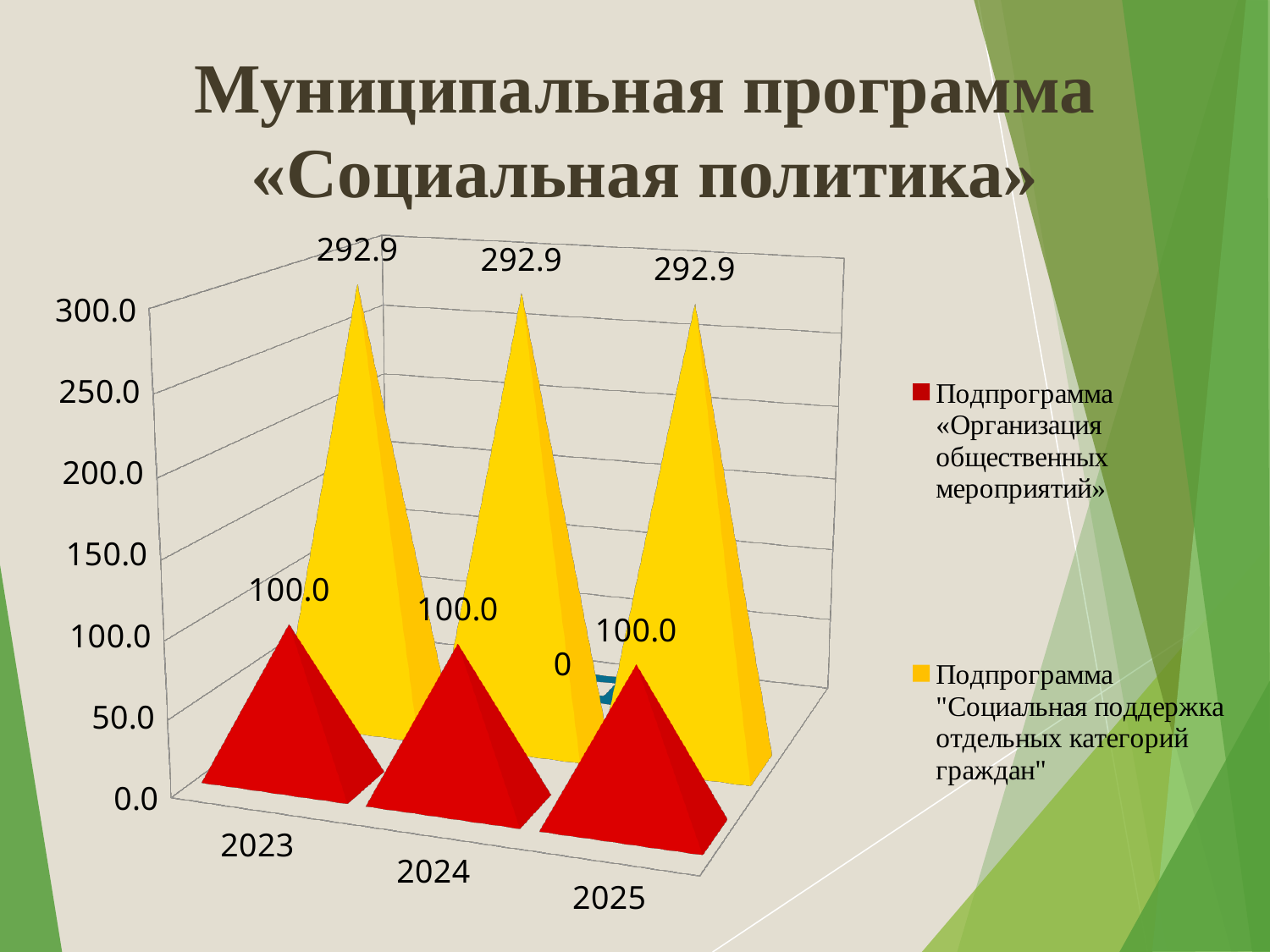
What kind of chart is shown on the slide? Bar chart What is the value for the red series «Организация общественных мероприятий» in 2023? 100.0 How many series does the legend list? 2 What is the value for the yellow series "Социальная поддержка отдельных категорий граждан" in 2024? 292.9 What is the value for the yellow series "Социальная поддержка отдельных категорий граждан" in 2025? 292.9 What is the difference between the yellow and red series values in 2024? 192.9 What colour represents the series "Социальная поддержка отдельных категорий граждан"? Yellow Is the value for the red series in 2024 greater or less than 150.0? less Which series has the larger value in 2023, «Организация общественных мероприятий» or "Социальная поддержка отдельных категорий граждан"? "Социальная поддержка отдельных категорий граждан" What is the value for the red series «Организация общественных мероприятий» in 2025? 100.0 Does the value of the yellow series rise, fall, or stay the same from 2023 to 2025? Stays the same How many years are shown on the x axis? 3